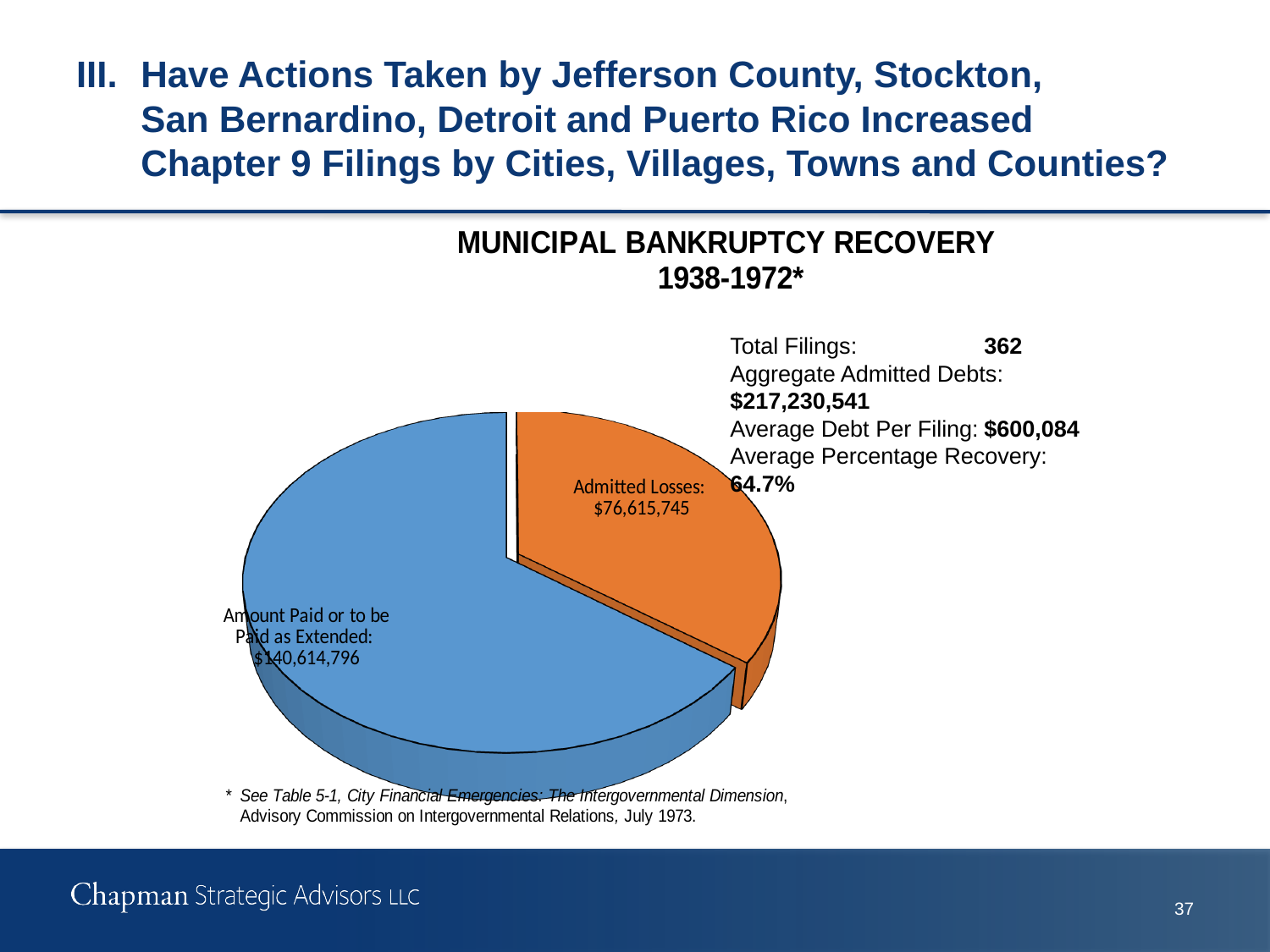
What type of chart is shown on the slide? Pie chart Which slice of the pie chart is the largest? Amount Paid or to be Paid as Extended Which slice of the pie chart is the smallest? Admitted Losses What is the title of the pie chart? MUNICIPAL BANKRUPTCY RECOVERY 1938-1972* What is the value of the Amount Paid or to be Paid as Extended slice in the pie chart? $140,614,796 What colour is the Admitted Losses slice in the pie chart? Orange How many slices does the pie chart have? 2 What is the value of the Admitted Losses slice in the pie chart? $76,615,745 What is the difference between the Amount Paid or to be Paid as Extended and the Admitted Losses in the pie chart? $63,999,051 What is the total of the two slices in the pie chart? $217,230,541 Which is larger in the pie chart: Admitted Losses or Amount Paid or to be Paid as Extended? Amount Paid or to be Paid as Extended What share of the pie does the Amount Paid or to be Paid as Extended slice represent? 64.7%